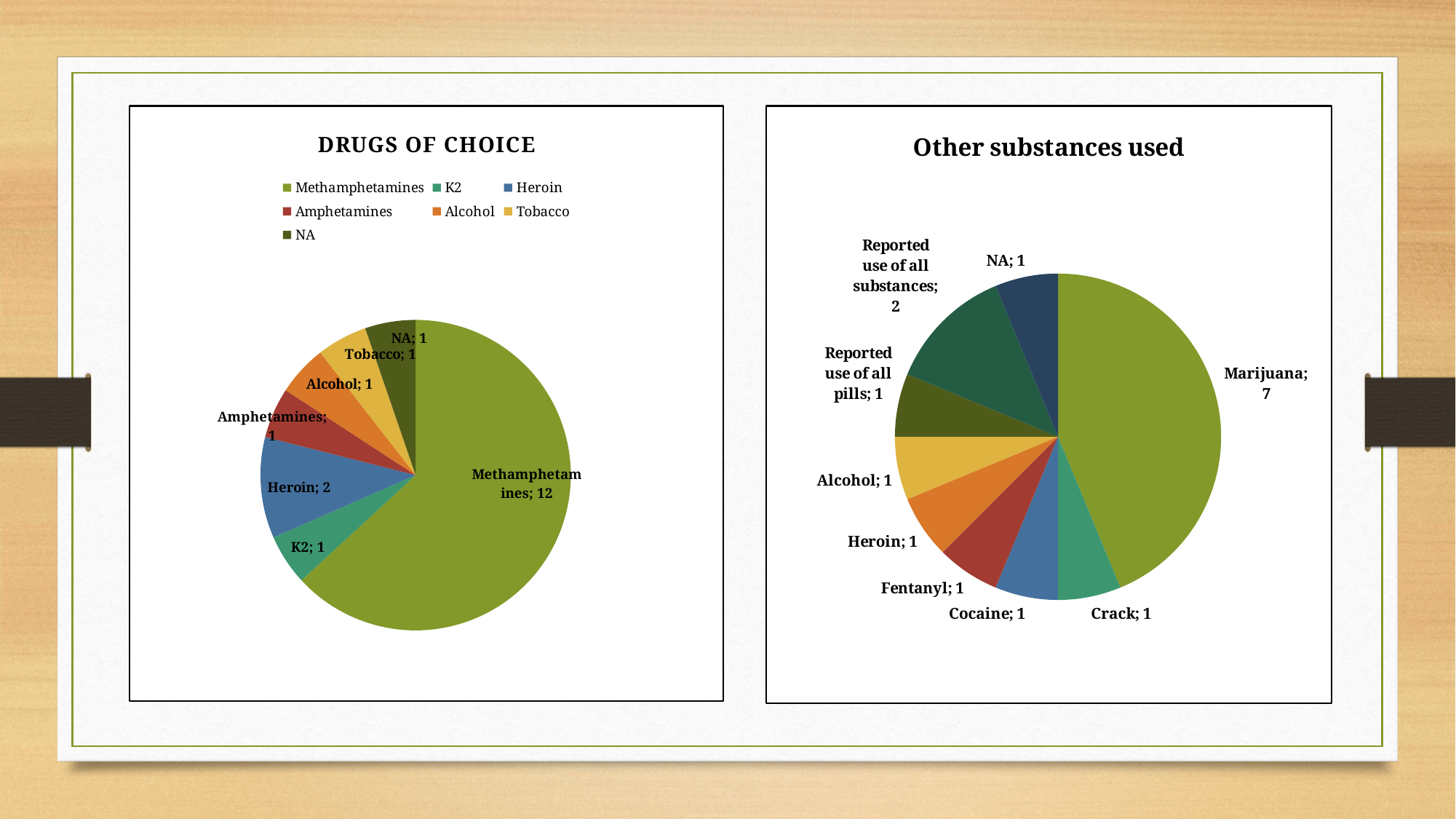
In the Other substances used chart, what is the value for Reported use of all substances? 2 In the DRUGS OF CHOICE chart, which category has the largest slice? Methamphetamines In the Other substances used chart, how many categories are shown? 9 In the DRUGS OF CHOICE chart, how many categories are shown? 7 What kind of chart is the DRUGS OF CHOICE chart? Pie chart In the Other substances used chart, which category has the largest slice? Marijuana In the DRUGS OF CHOICE chart, what is the value for Heroin? 2 In the Other substances used chart, what is the value for Marijuana? 7 In the Other substances used chart, which is larger, Marijuana or Reported use of all substances? Marijuana In the Other substances used chart, what is the difference between the values for Marijuana and Crack? 6 In the DRUGS OF CHOICE chart, what is the value for Methamphetamines? 12 In the DRUGS OF CHOICE chart, what is the difference between the values for Methamphetamines and Heroin? 10